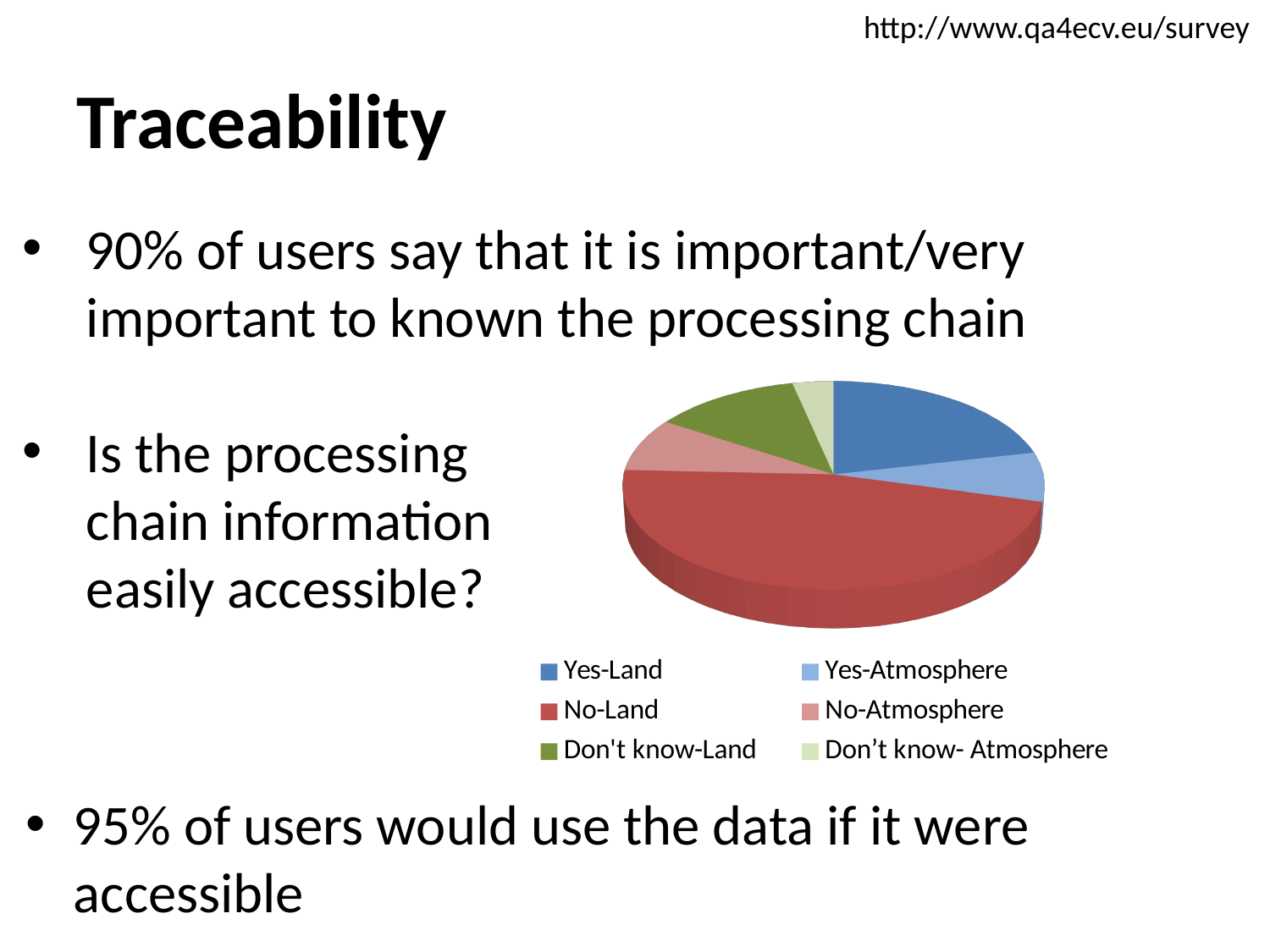
How many slices does the pie chart have? 6 Which slice is larger, No-Land or No-Atmosphere? No-Land Which category has the largest slice of the pie chart? No-Land Which slice is larger, Don't know-Land or Don't know- Atmosphere? Don't know-Land Which legend entry is shown in dark blue? Yes-Land Which slice is larger, No-Land or Yes-Land? No-Land Which category has the smallest slice of the pie chart? Don't know- Atmosphere What colour is the No-Land slice in the pie chart? Red What kind of chart is shown on the slide? Pie chart